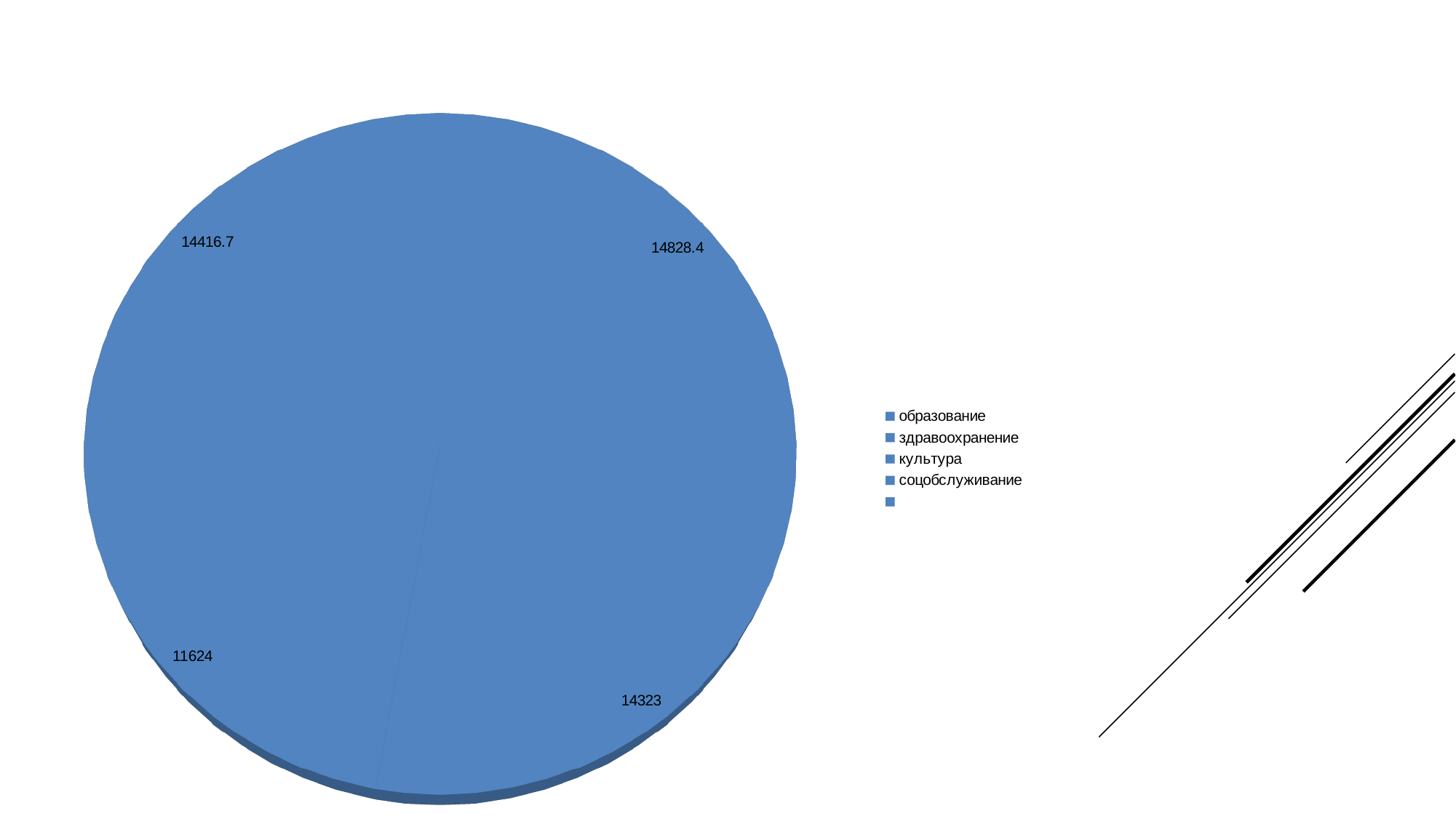
What is the first entry listed in the legend? образование What value is printed at the bottom-left of the pie chart? 11624 What is the largest value printed on the pie chart? 14828.4 What value is printed at the top-right of the pie chart? 14828.4 What is the difference between the largest printed value (14828.4) and the smallest printed value (11624)? 3204.4 What is the smallest value printed on the pie chart? 11624 What kind of chart is shown on the slide? pie chart What colour are the slices of the pie chart? blue What is the difference between the printed values 14828.4 and 14416.7? 411.7 How many data labels are printed on the pie chart? 4 Which printed value is larger, 14416.7 or 14323? 14416.7 How many named entries does the legend list? 4